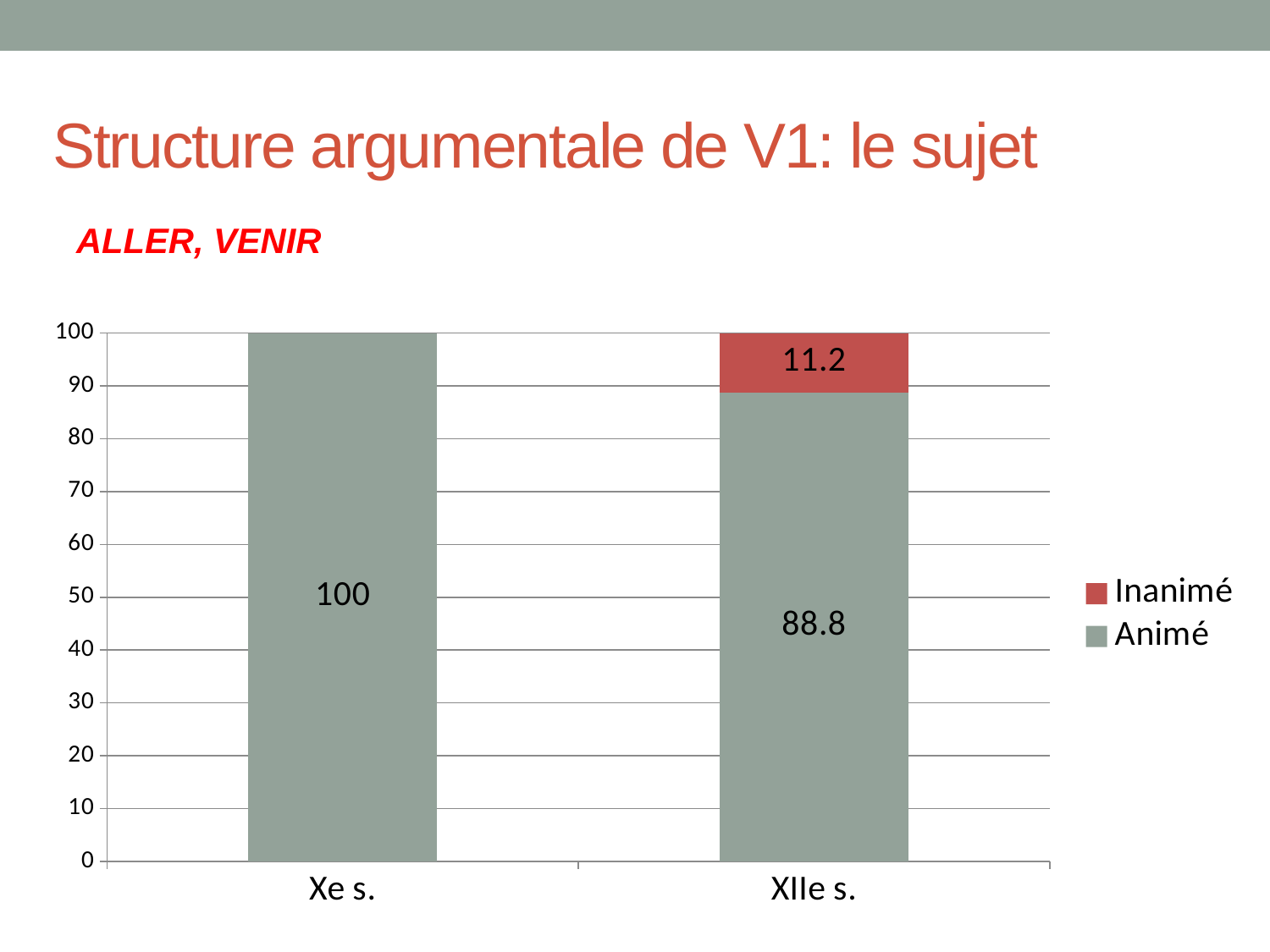
What is the total of the stacked bar for XIIe s.? 100 Which series is shown in red in the legend? Inanimé How many series does the legend list? 2 What is the difference between the Animé values for Xe s. and XIIe s.? 11.2 How many categories are shown on the x axis? 2 What is the Animé value for Xe s.? 100 What is the Inanimé value for XIIe s.? 11.2 Which verbs are named in the subtitle above the chart? ALLER, VENIR Does the Animé value rise or fall from Xe s. to XIIe s.? Fall What is the Animé value for XIIe s.? 88.8 Which category has the higher Animé value, Xe s. or XIIe s.? Xe s. What kind of chart is shown on the slide? Stacked bar chart